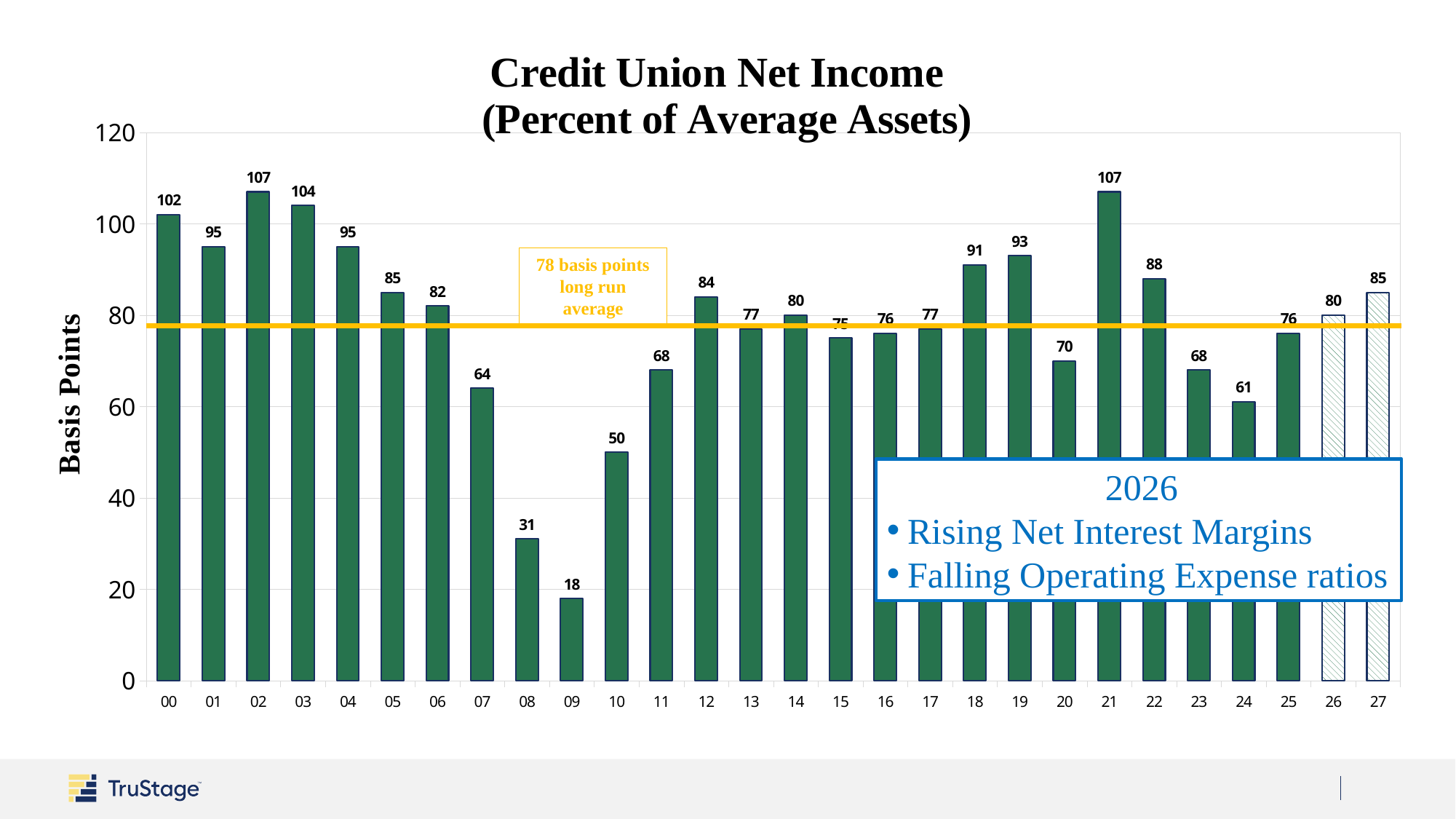
What is the value for 21? 107 Do the values rise or fall from 05 to 09? fall What long run average does the horizontal line mark? 78 basis points What is the value for 27? 85 Which year has the lowest value? 09 Is the value for 24 greater or less than 80? less What is the difference between the values for 22 and 23? 20 What is the difference between the values for 08 and 09? 13 What is the value for 09? 18 Which is larger, the value for 18 or the value for 19? 19 What kind of chart is this? bar chart How many bars are shown in the chart? 28